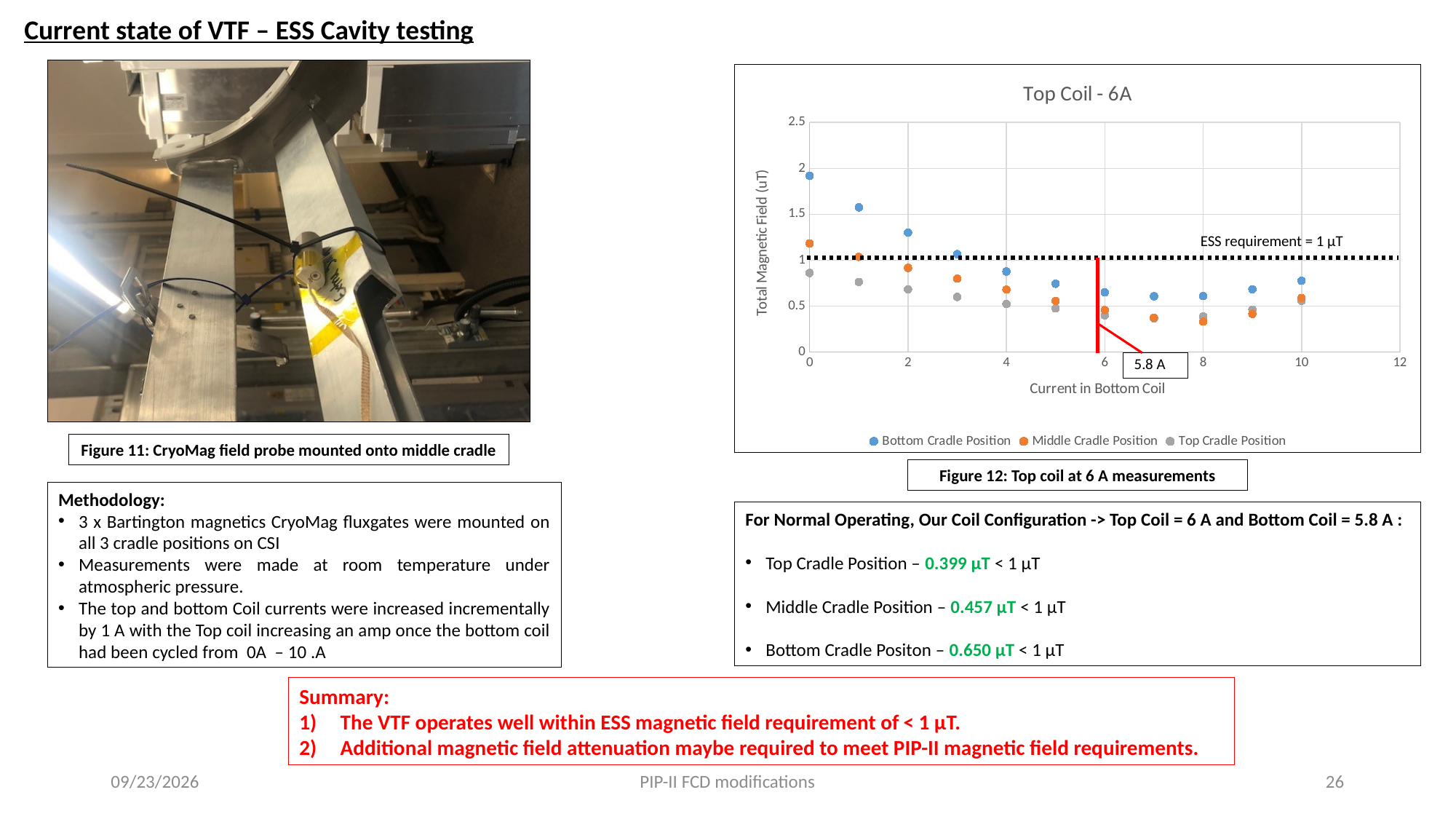
What kind of chart is shown in Figure 12 (Top Coil - 6A)? scatter chart Which series has the highest value at 0 A on the Top Coil - 6A chart? Bottom Cradle Position What is the title of the chart on the slide? Top Coil - 6A Which series has the lowest value at 2 A on the Top Coil - 6A chart? Top Cradle Position Does the Bottom Cradle Position series rise or fall as the current increases from 0 A to 6 A? fall How many data points does the Bottom Cradle Position series have on the chart? 11 At 0 A, which series has the higher value: Bottom Cradle Position or Top Cradle Position? Bottom Cradle Position Is the Top Cradle Position value at 0 A greater or less than 1? less How many series does the legend of the Top Coil - 6A chart list? 3 Is the Bottom Cradle Position value at 0 A greater or less than 1.5? greater According to the dotted line label on the chart, what is the ESS requirement? 1 µT Is the Middle Cradle Position value at 8 A greater or less than 0.5? less